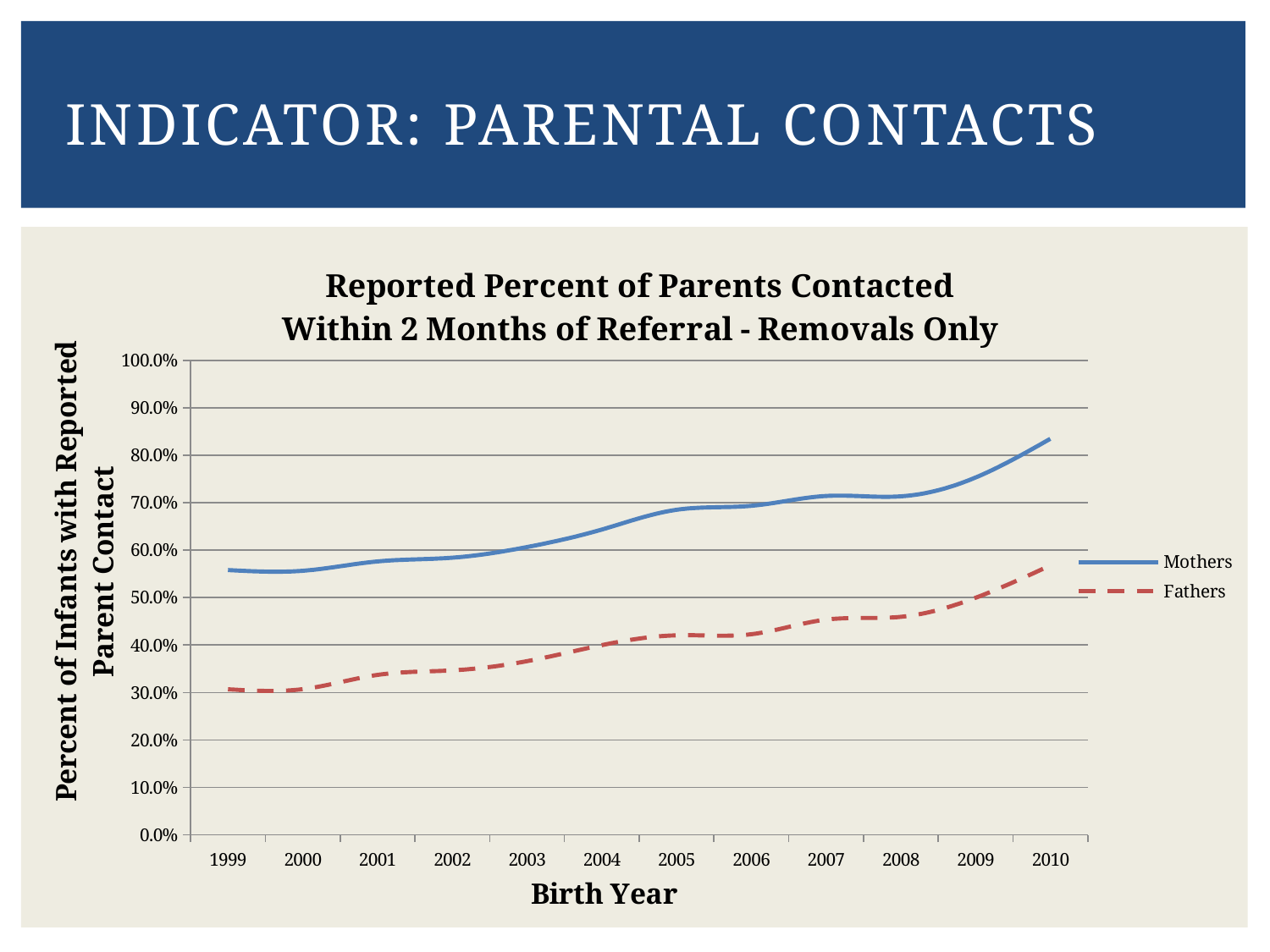
Does the Fathers line rise or fall from 1999 to 2010? rise Does the Mothers line rise or fall from 1999 to 2010? rise Is the Mothers value for 2010 greater or less than 80.0%? greater In which birth year is the Fathers value highest? 2010 How many series does the legend list? 2 Is the Fathers value for 2005 greater or less than 50.0%? less How many birth years are plotted along the x axis? 12 Is the Fathers value for 1999 greater or less than 40.0%? less Which series has the higher value in 2010, Mothers or Fathers? Mothers In which birth year is the Mothers value highest? 2010 What is the label of the x axis? Birth Year What kind of chart is shown on the slide? line chart